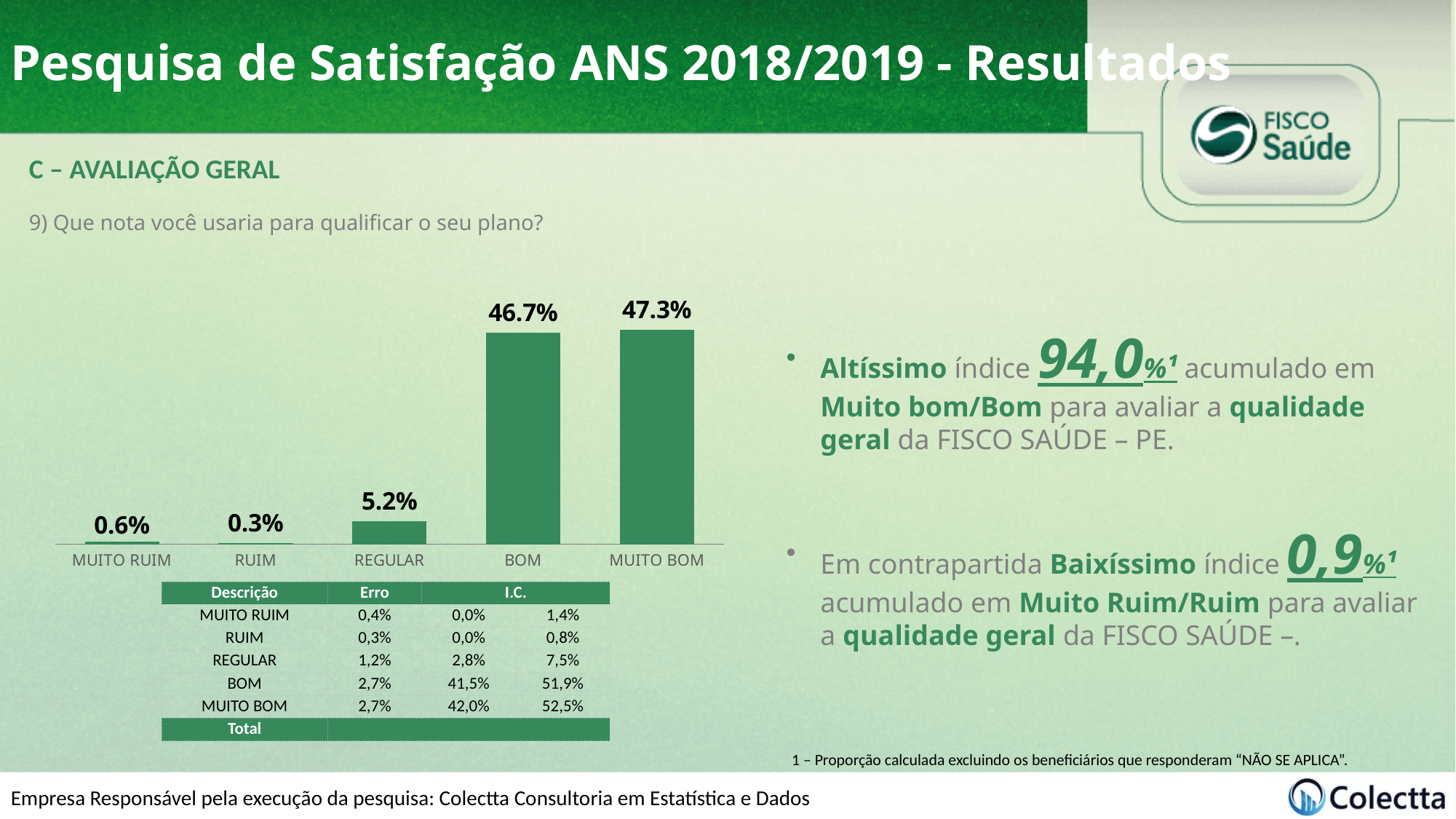
How many categories are shown in the bar chart? 5 What percentage is shown for BOM in the bar chart? 46.7% Which category has the highest value in the bar chart? MUITO BOM What percentage is shown for REGULAR in the bar chart? 5.2% What percentage is shown for MUITO RUIM in the bar chart? 0.6% What is the difference between the values for MUITO BOM and BOM? 0.6% What is the difference between the values for BOM and REGULAR? 41.5% Which category has the lowest value in the bar chart? RUIM Which is larger, the value for REGULAR or the value for MUITO RUIM? REGULAR What percentage is shown for MUITO BOM in the bar chart? 47.3% Do the values generally rise or fall from MUITO RUIM to MUITO BOM along the x axis? Rise What kind of chart is shown on the slide? Bar chart